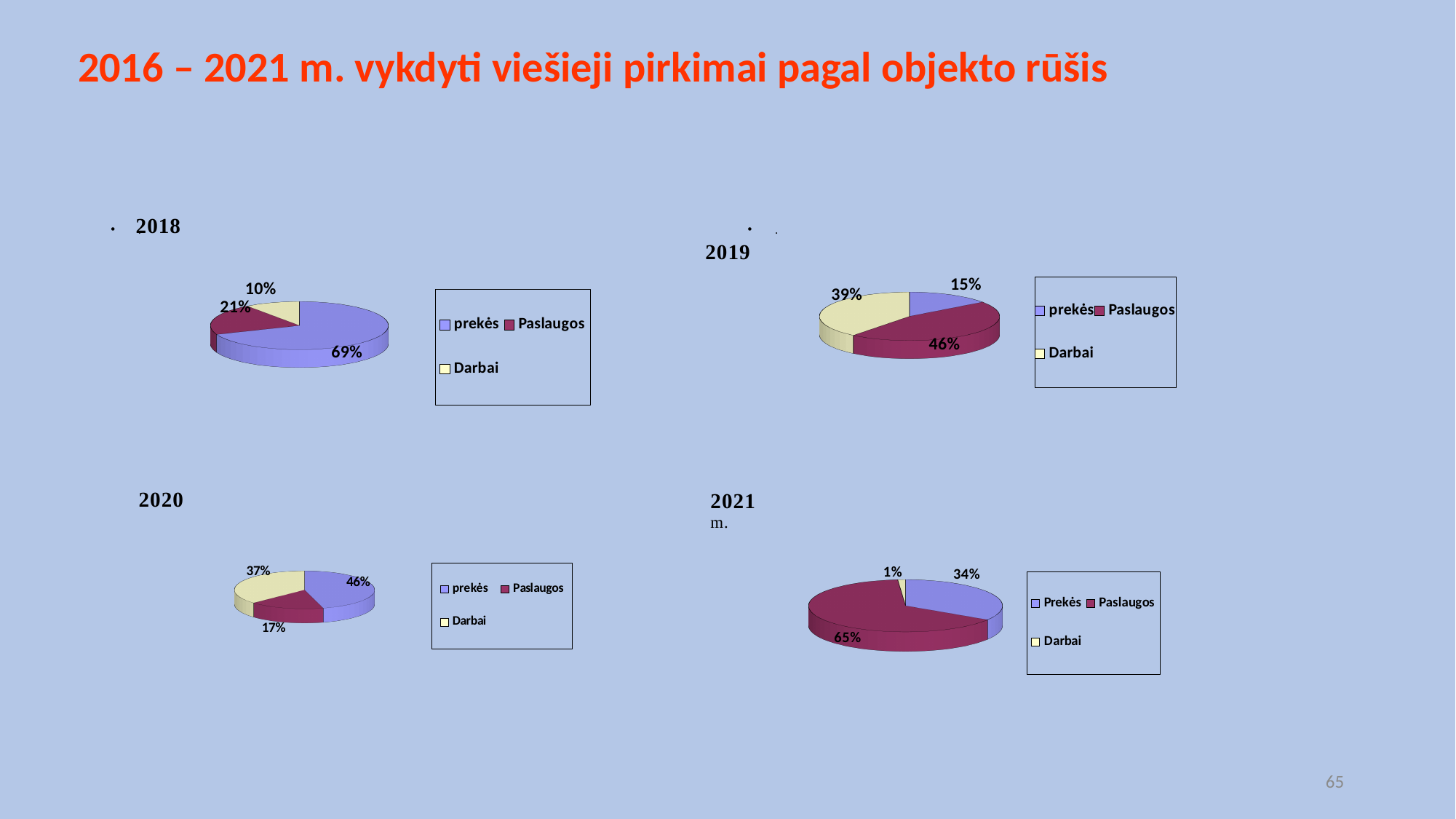
In the 2020 pie chart, what share does Darbai have? 37% In the 2021 pie chart, which category has the smallest share? Darbai In the 2019 pie chart, what share does Paslaugos have? 46% In the 2018 pie chart, what share does prekės have? 69% In the 2021 pie chart, what share does Darbai have? 1% In the 2018 pie chart, which category has the largest share? prekės In the 2020 pie chart, what is the difference between the prekės share and the Paslaugos share? 29% In the 2019 pie chart, which category has the largest share? Paslaugos How many entries does the legend of the 2021 pie chart list? 3 How many pie charts are shown on the slide? 4 In the 2019 pie chart, which is larger, the share for Darbai or the share for prekės? Darbai What type of chart is used for the 2018 data? Pie chart